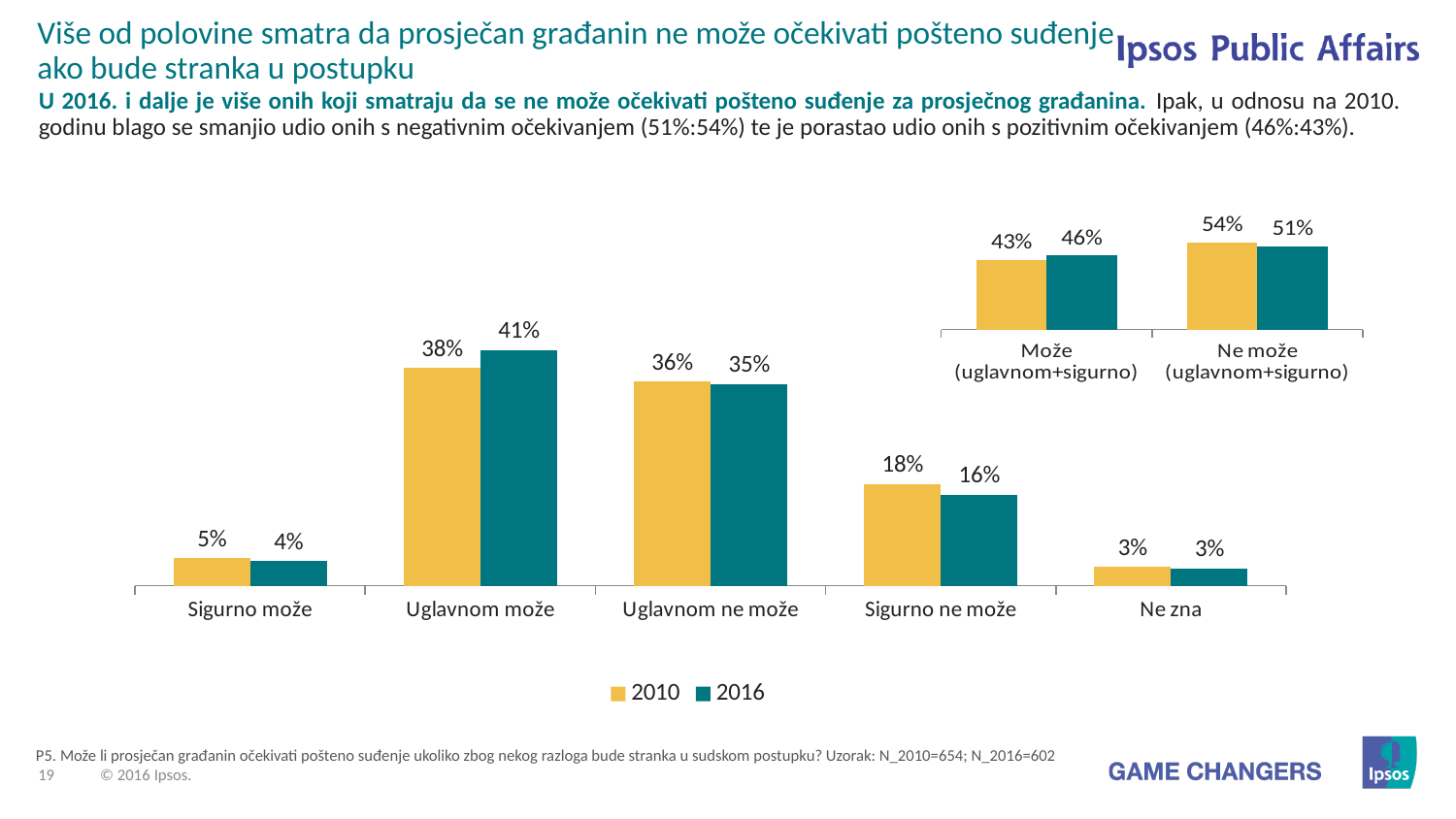
In the small inset chart at the top right, what is the 2016 value for 'Ne može (uglavnom+sigurno)'? 51% In the main bar chart, what is the value for 'Uglavnom može' in 2016? 41% In the main bar chart, what is the value for 'Sigurno ne može' in 2010? 18% Which two years are listed in the legend of the main bar chart? 2010 and 2016 What type of chart is the main chart on the slide? bar chart In the main bar chart, which category has the lowest value for 2016? Ne zna In the main bar chart, which category has the highest value for 2010? Uglavnom može How many series does the legend of the main bar chart list? 2 In the main bar chart, what is the difference between the 2010 and 2016 values for 'Sigurno ne može'? 2% In the main bar chart, is the 2010 value for 'Uglavnom ne može' larger or smaller than the 2016 value? larger In the small inset chart at the top right, what is the difference between the 2010 and 2016 values for 'Može (uglavnom+sigurno)'? 3% How many categories are shown on the x axis of the main bar chart? 5